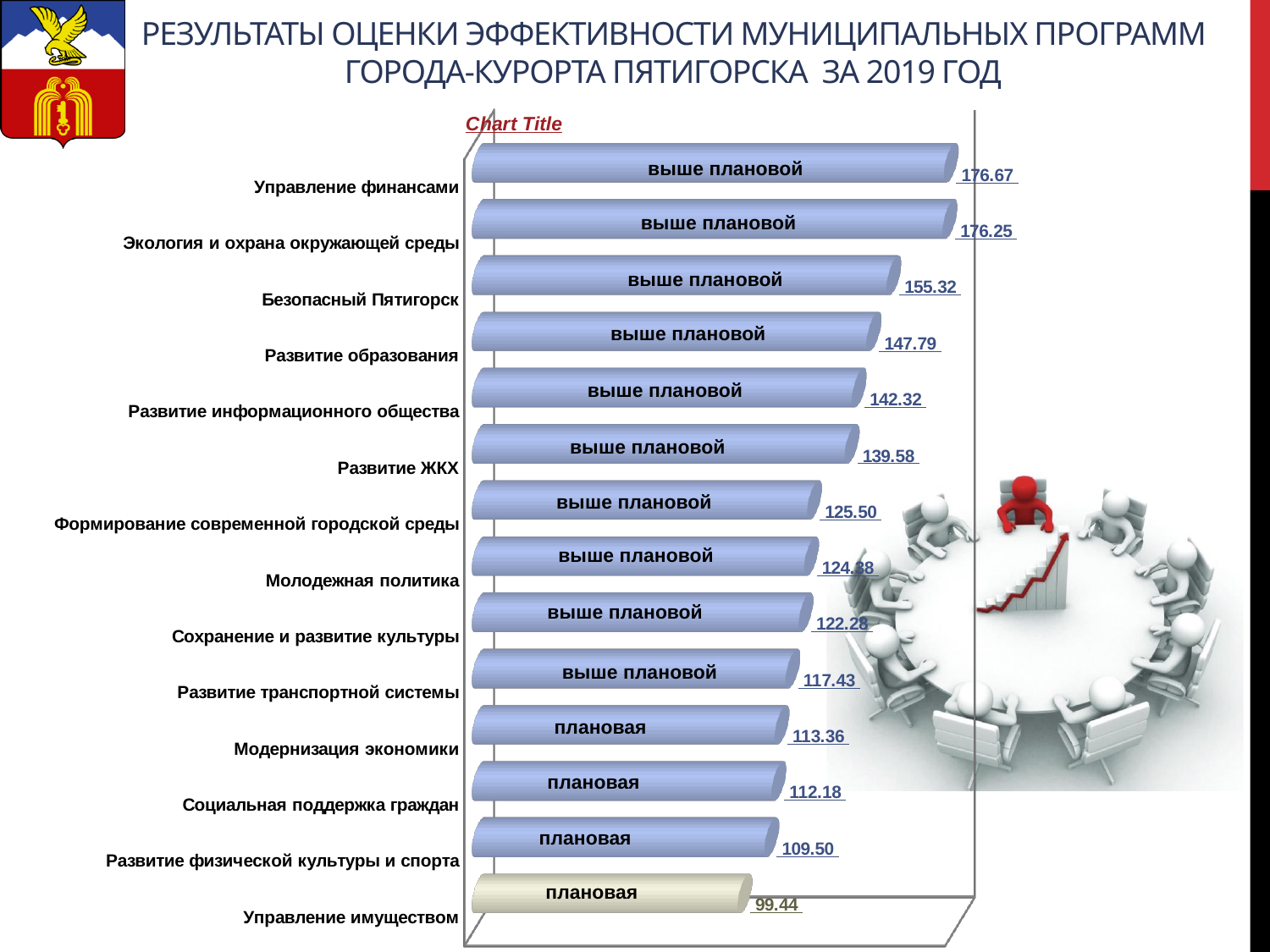
What is the value for Развитие физической культуры и спорта? 109.50 What label is printed inside the bar for Развитие транспортной системы? выше плановой What is the value for Управление финансами? 176.67 What type of chart is shown on the slide? bar chart What is the difference between the values for Развитие образования and Развитие информационного общества? 5.47 What is the difference between the values for Управление финансами and Управление имуществом? 77.23 What is the value for Управление имуществом? 99.44 Which is larger, the value for Модернизация экономики or the value for Социальная поддержка граждан? Модернизация экономики How many categories are shown in the chart? 14 Which category has the lowest value? Управление имуществом What is the value for Безопасный Пятигорск? 155.32 What is the value for Развитие ЖКХ? 139.58